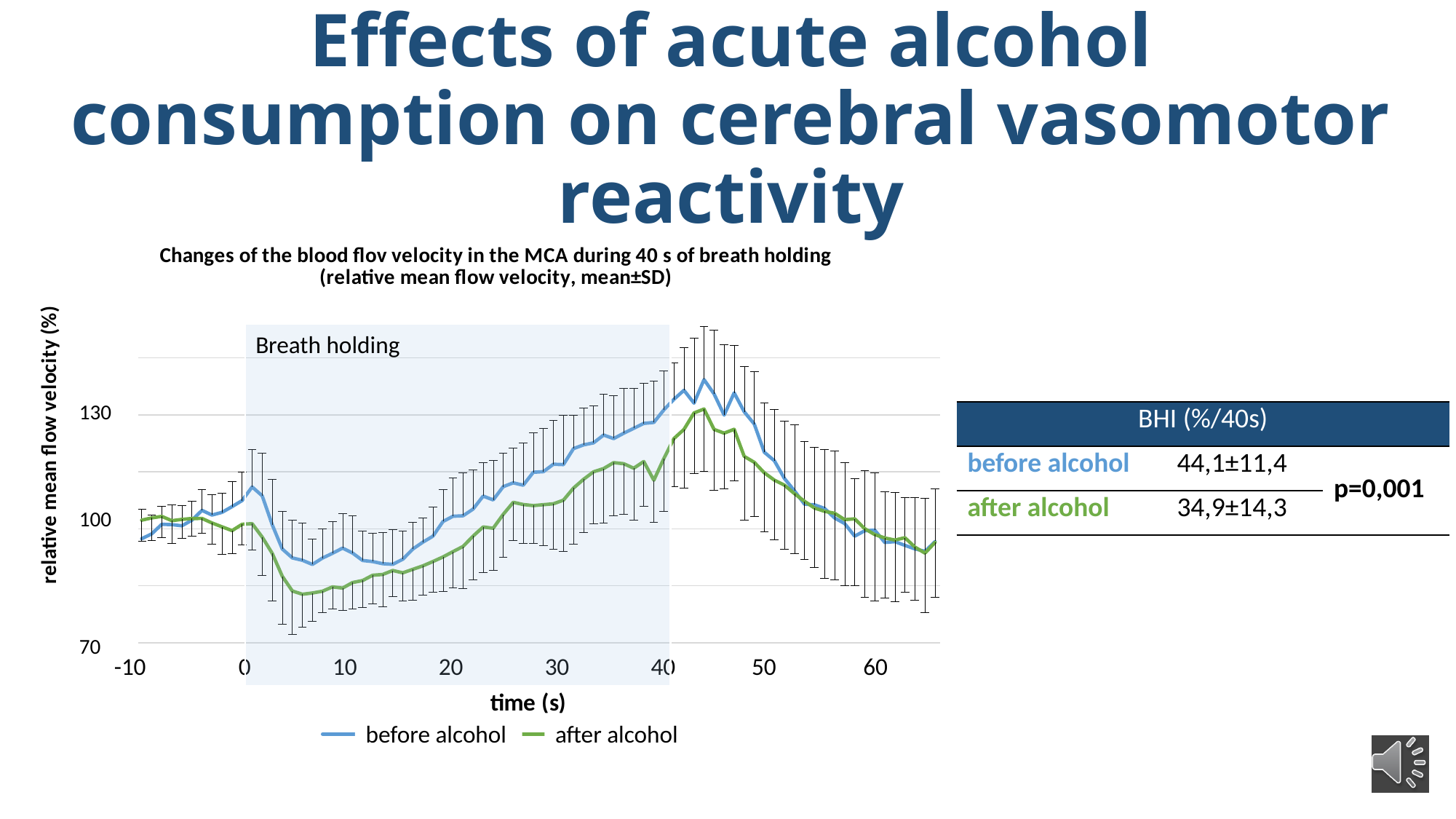
Is the peak value of the before alcohol series (around 44 s) greater or less than 130? greater At 20 s, which series has the higher value, before alcohol or after alcohol? before alcohol What label is shown on the shaded region of the chart between 0 and 40 s? Breath holding What are the two series named in the chart legend? before alcohol, after alcohol Do the values of the before alcohol series rise or fall between 10 s and 40 s? rise What kind of chart is shown on the slide? line chart Is the value for the after alcohol series at 5 s greater or less than 100? less Is the value for the before alcohol series at 30 s greater or less than 100? greater How many series does the chart legend list? 2 Do the values of the after alcohol series rise or fall between 45 s and 60 s? fall Which series reaches the higher peak value, before alcohol or after alcohol? before alcohol